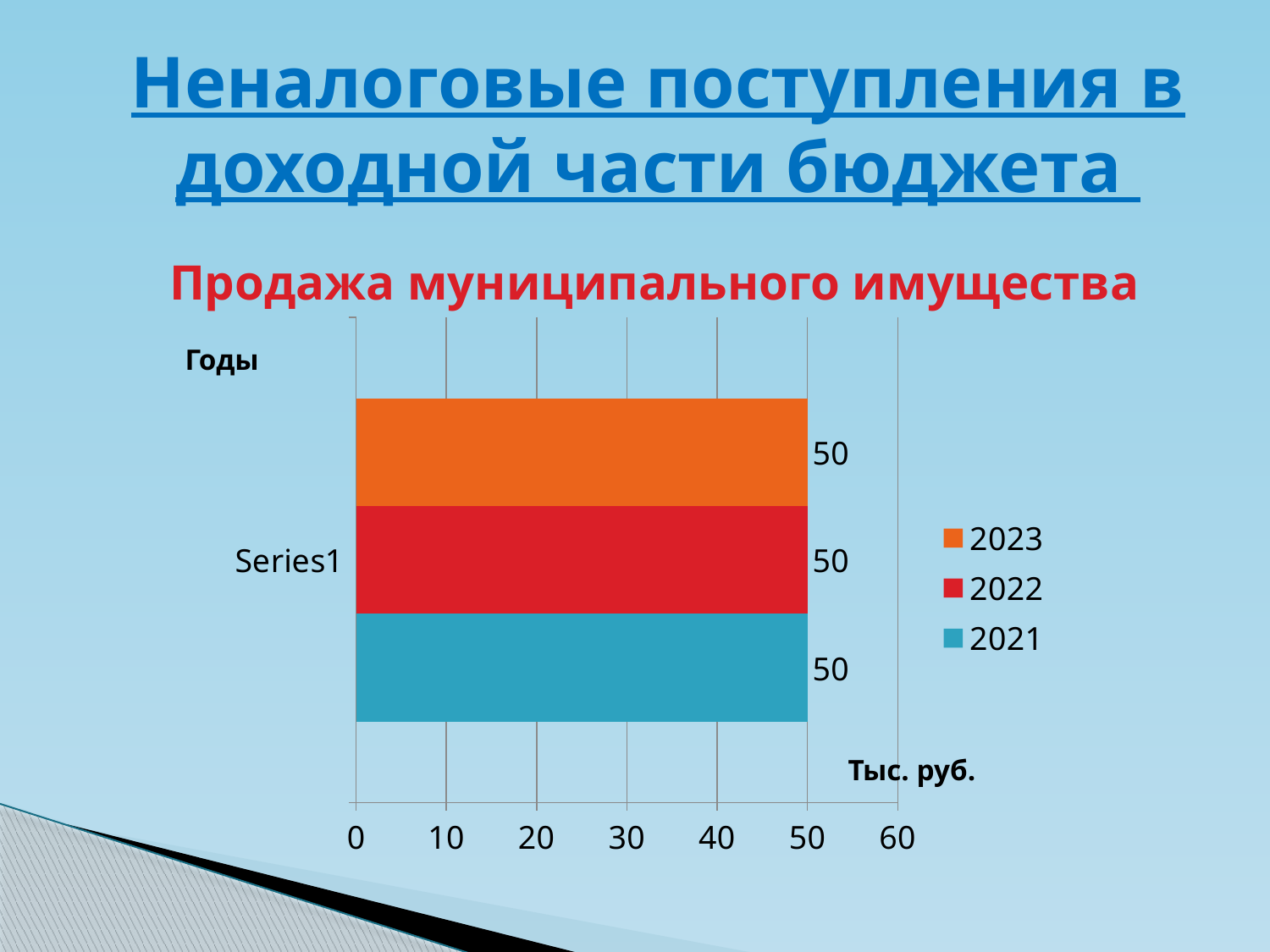
What unit is shown on the horizontal axis of the chart? Тыс. руб. Is the value for 2021 greater or less than 60? less How many series does the legend list? 3 What is the value for 2023 in the chart? 50 How many categories are shown on the vertical axis of the chart? 1 What is the value for 2022 in the chart? 50 Is the value for 2022 greater or less than 40? greater What is the value for 2021 in the chart? 50 What is the difference between the values for 2023 and 2021? 0 What kind of chart is shown on the slide? bar chart What is the title of the chart? Продажа муниципального имущества